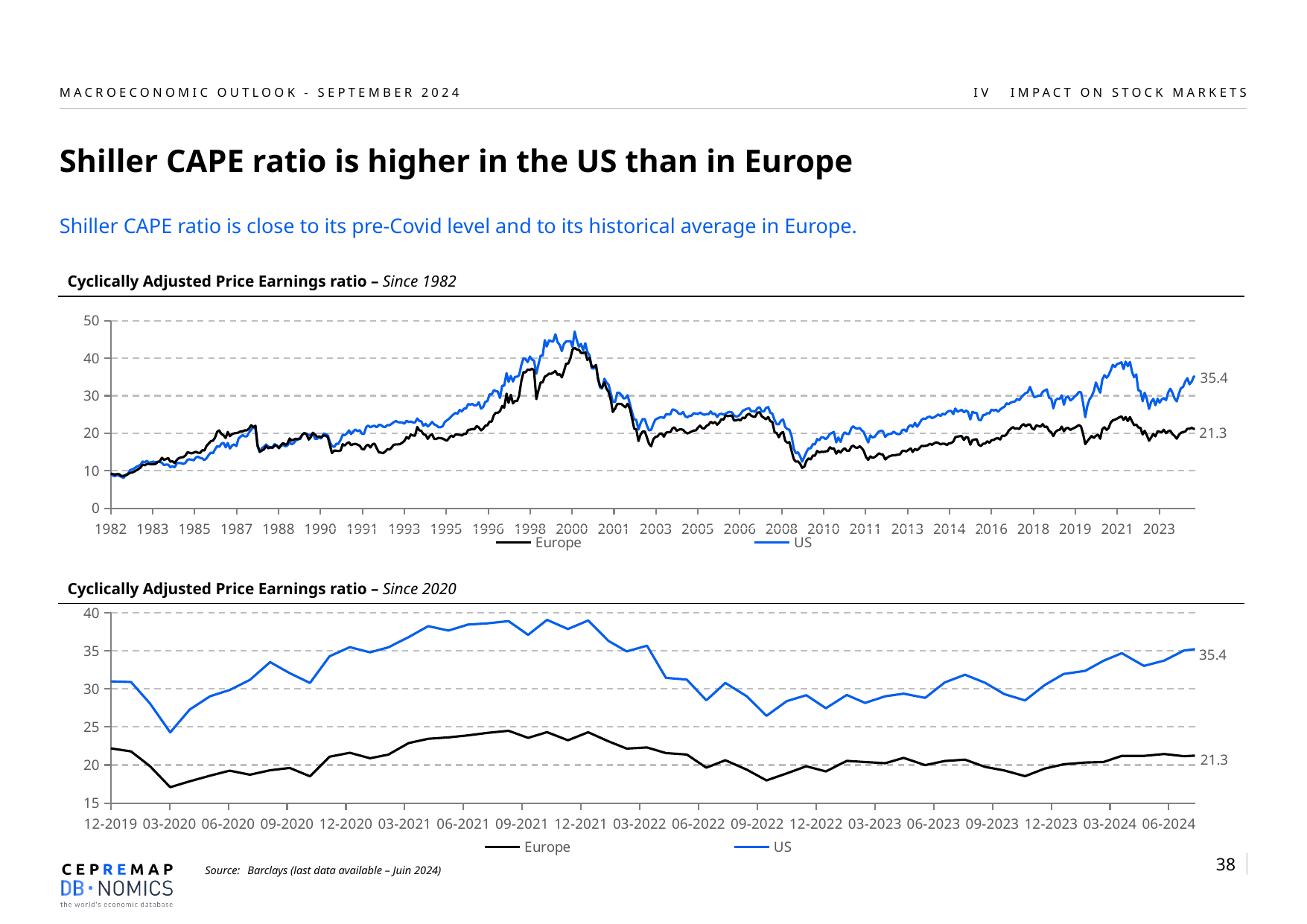
In the 'Cyclically Adjusted Price Earnings ratio – Since 2020' chart, what is the latest labelled value for the Europe series? 21.3 In the 'Cyclically Adjusted Price Earnings ratio – Since 2020' chart, does the US series rise or fall between 12-2021 and 09-2022? fall In the 'Cyclically Adjusted Price Earnings ratio – Since 1982' chart, is the peak US value around 2000 greater or less than 40? greater In the 'Cyclically Adjusted Price Earnings ratio – Since 2020' chart, is the Europe value at 03-2020 greater or less than 20? less What colour is the US series drawn in on the 'Cyclically Adjusted Price Earnings ratio – Since 2020' chart? Blue How many series does the legend of the 'Cyclically Adjusted Price Earnings ratio – Since 2020' chart list? 2 In the 'Cyclically Adjusted Price Earnings ratio – Since 1982' chart, which series has the higher latest labelled value, US or Europe? US In the 'Cyclically Adjusted Price Earnings ratio – Since 2020' chart, is the US value at 03-2020 greater or less than 30? less What kind of chart is the 'Cyclically Adjusted Price Earnings ratio – Since 1982' chart? Line chart What are the two legend entries in the 'Cyclically Adjusted Price Earnings ratio – Since 1982' chart? Europe and US In the 'Cyclically Adjusted Price Earnings ratio – Since 2020' chart, what is the difference between the latest labelled US value and the latest labelled Europe value? 14.1 In the 'Cyclically Adjusted Price Earnings ratio – Since 1982' chart, what is the latest labelled value for the US series? 35.4